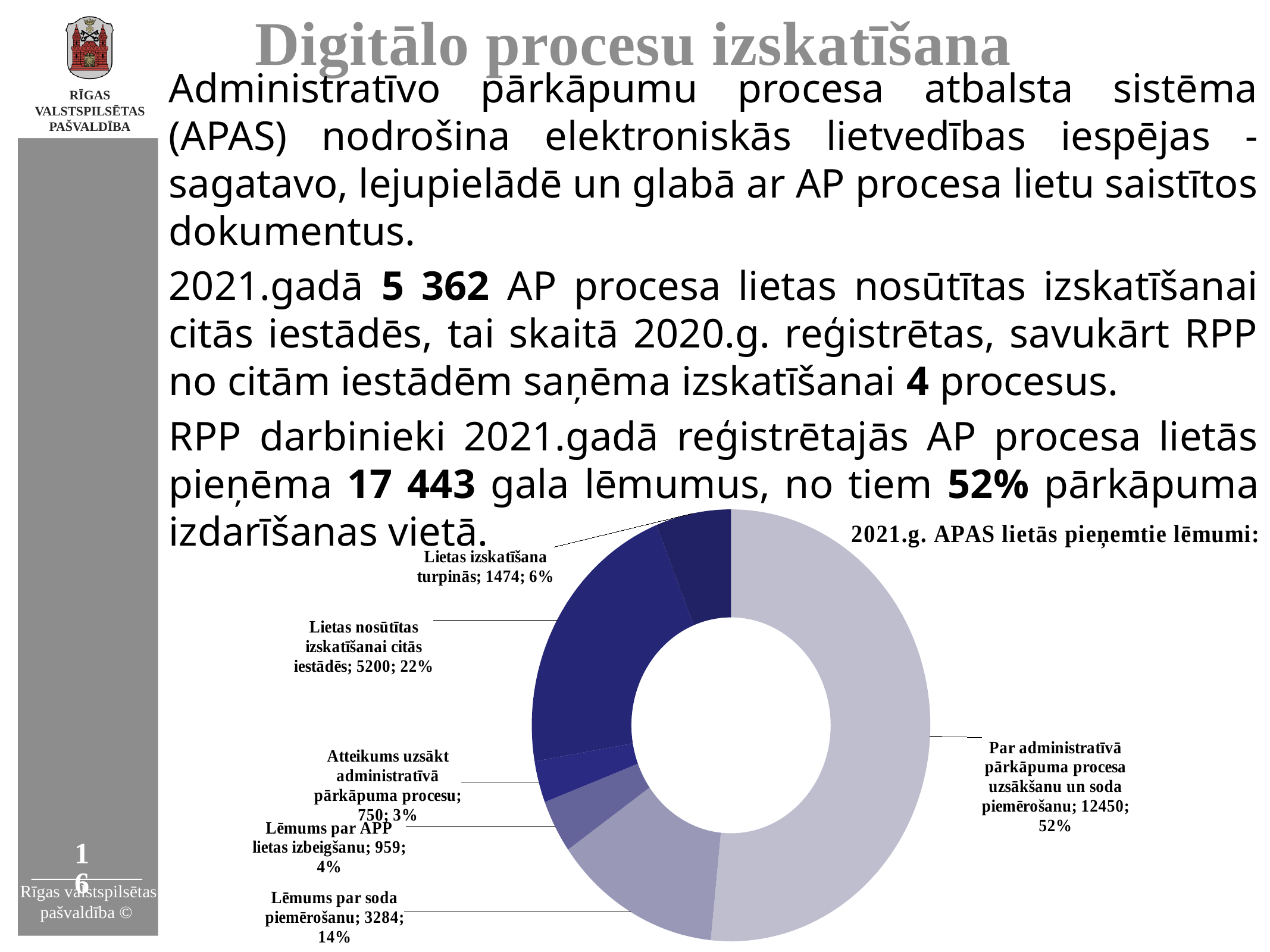
Which category has the smallest slice? Atteikums uzsākt administratīvā pārkāpuma procesu How many slices does the chart have? 6 What is the value for "Lēmums par soda piemērošanu"? 3284 What kind of chart is shown on the slide? Pie (doughnut) chart What share of the chart does "Lēmums par APP lietas izbeigšanu" represent? 4% What is the value for "Par administratīvā pārkāpuma procesa uzsākšanu un soda piemērošanu"? 12450 What is the title of the chart? 2021.g. APAS lietās pieņemtie lēmumi: Which category has the largest slice? Par administratīvā pārkāpuma procesa uzsākšanu un soda piemērošanu What is the difference between the values for "Lietas nosūtītas izskatīšanai citās iestādēs" and "Lēmums par soda piemērošanu"? 1916 What share of the chart does "Atteikums uzsākt administratīvā pārkāpuma procesu" represent? 3% What is the value for "Lietas nosūtītas izskatīšanai citās iestādēs"? 5200 What is the value for "Lietas izskatīšana turpinās"? 1474